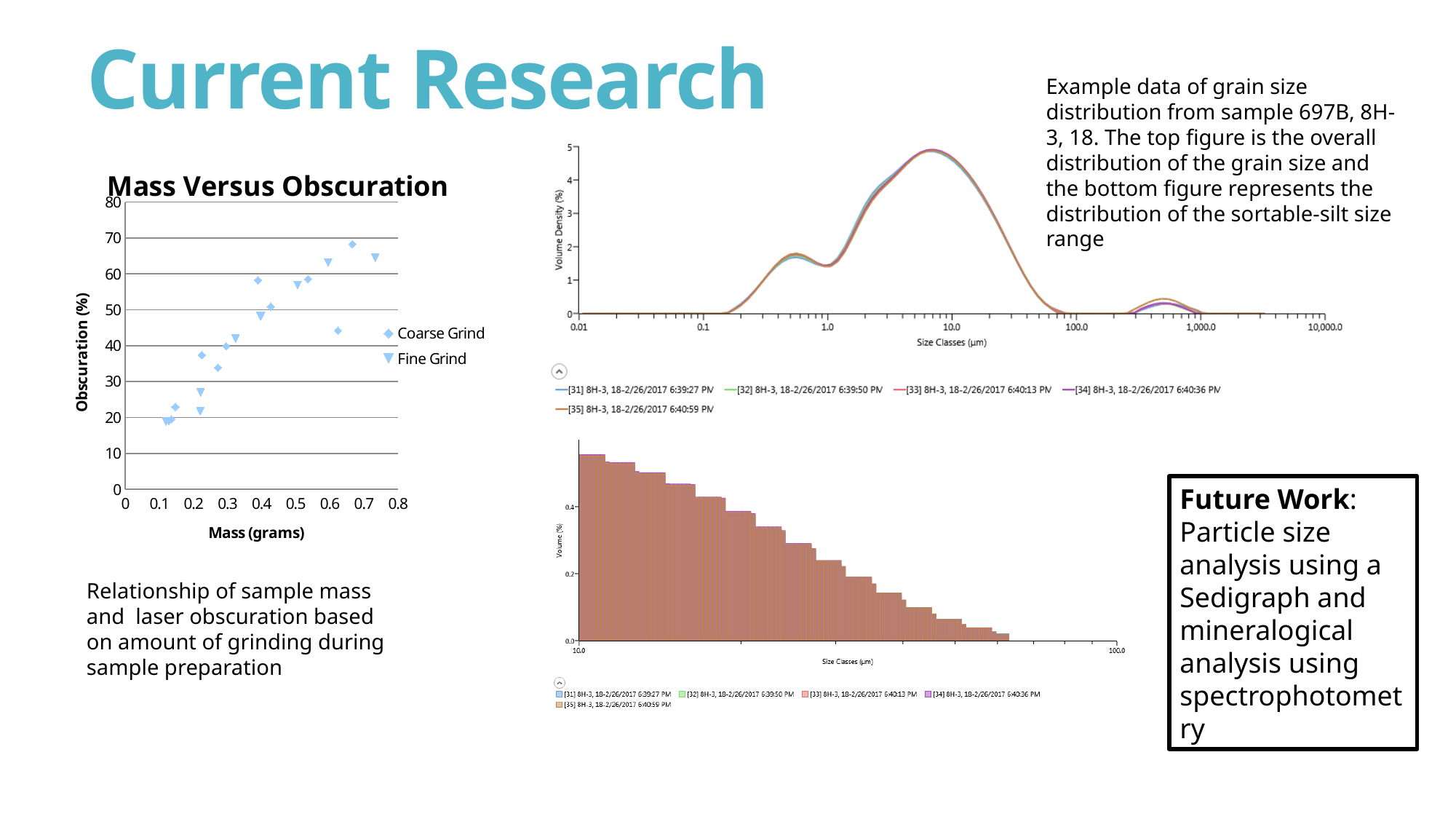
In the "Mass Versus Obscuration" chart, is the highest Coarse Grind point greater or less than 60? greater In the top right chart (Volume Density vs Size Classes), is the highest peak of the curves greater or less than 4? greater What kind of chart is the bottom right chart (Volume vs Size Classes from 10.0 to 100.0)? Bar chart In the "Mass Versus Obscuration" chart, are the points at the smallest mass (around 0.1 grams) greater or less than 30? less How many series does the legend of the top right chart (Volume Density vs Size Classes) list? 5 What are the two series named in the legend of the "Mass Versus Obscuration" chart? Coarse Grind and Fine Grind What is the label of the x axis of the "Mass Versus Obscuration" chart? Mass (grams) In the bottom right chart (Volume vs Size Classes), do the values rise or fall as size class increases along the x axis? Fall In the "Mass Versus Obscuration" chart, does obscuration generally rise or fall as mass increases? Rise What kind of chart is the "Mass Versus Obscuration" chart? Scatter chart What kind of chart is the top chart on the right side of the slide (Volume Density vs Size Classes)? Line chart How many series does the legend of the "Mass Versus Obscuration" chart list? 2